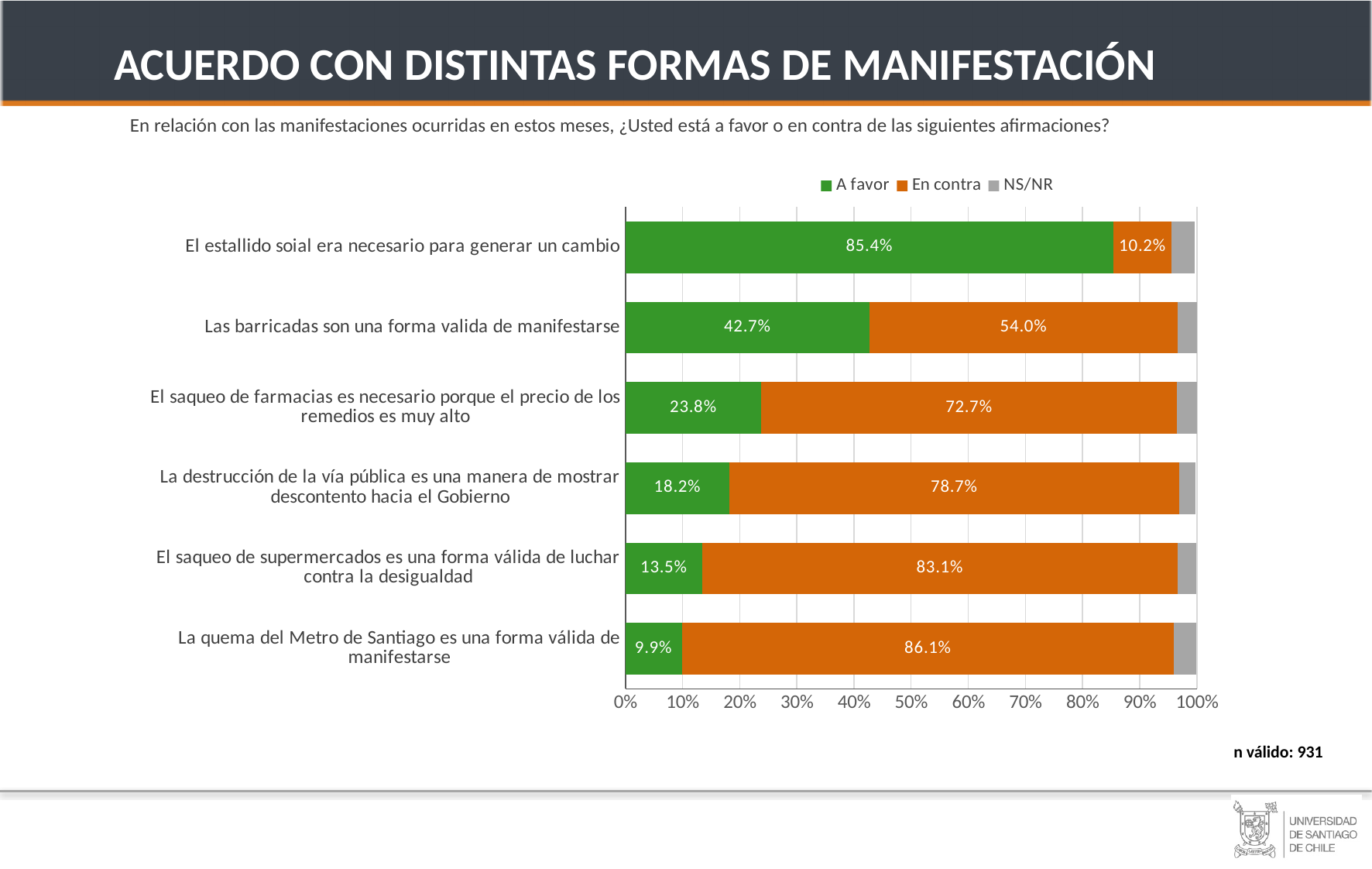
Which has a larger 'A favor' value: 'Las barricadas son una forma valida de manifestarse' or 'El saqueo de farmacias es necesario porque el precio de los remedios es muy alto'? Las barricadas son una forma valida de manifestarse Which statement has the highest 'A favor' percentage? El estallido soial era necesario para generar un cambio What is the difference between 'A favor' and 'En contra' for 'El estallido soial era necesario para generar un cambio'? 75.2 percentage points What type of chart is shown on the slide? Stacked bar chart How many series does the legend list? 3 What is the 'En contra' value for 'El saqueo de supermercados es una forma válida de luchar contra la desigualdad'? 83.1% What is the 'En contra' value for 'Las barricadas son una forma valida de manifestarse'? 54.0% Which statement has the lowest 'A favor' percentage? La quema del Metro de Santiago es una forma válida de manifestarse What is the 'A favor' value for 'La quema del Metro de Santiago es una forma válida de manifestarse'? 9.9% How many statements are shown in the chart? 6 What percentage is 'A favor' for 'El estallido soial era necesario para generar un cambio'? 85.4% Is the 'NS/NR' value for 'El estallido soial era necesario para generar un cambio' greater or less than 10%? less